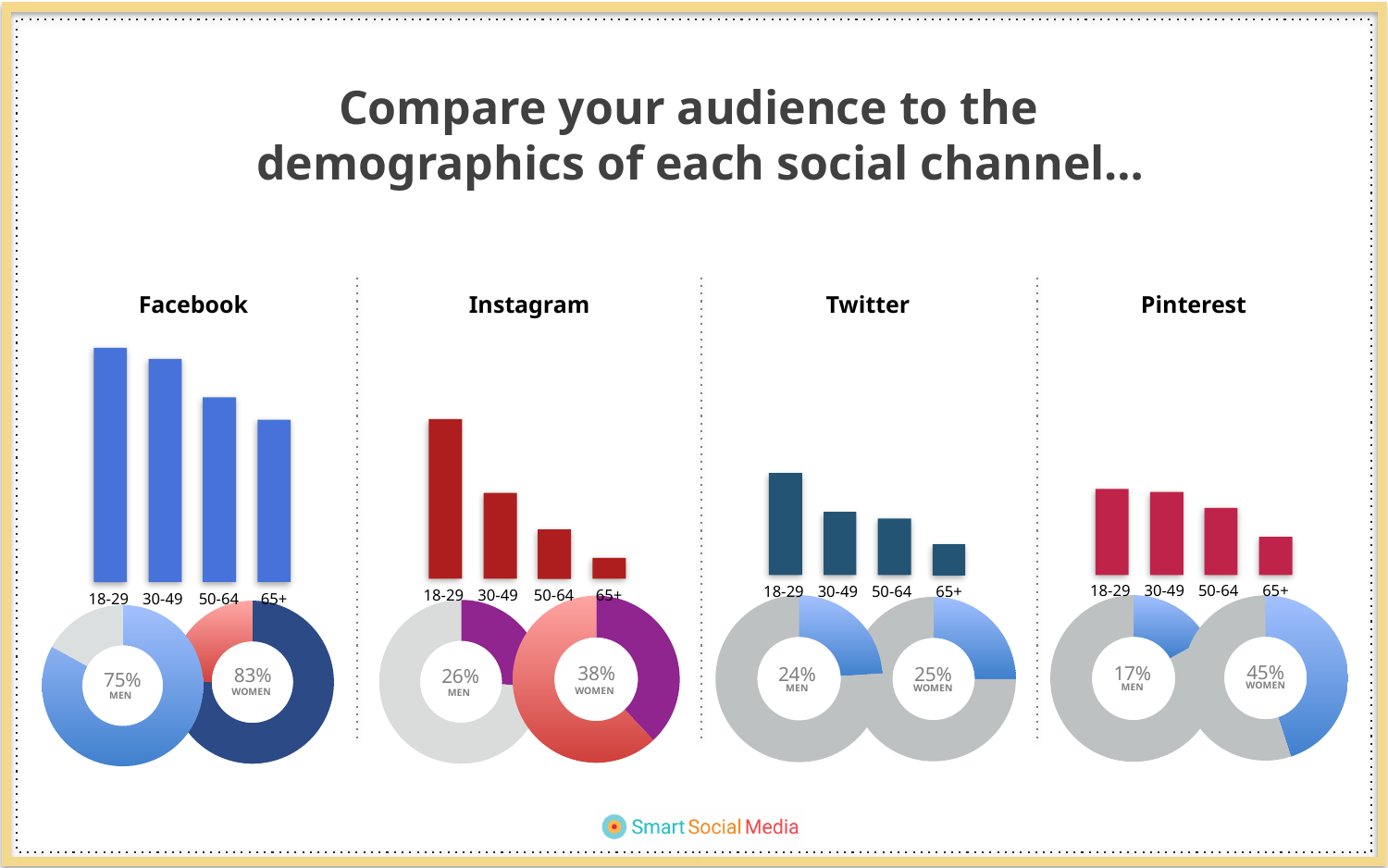
On the Facebook donut charts, what percentage is shown for women? 83% On the Facebook donut charts, what is the difference between the women's and men's percentages? 8% On the Instagram donut charts, which is larger, the men's or the women's percentage? Women On the Twitter donut charts, what percentage is shown for men? 24% How many age-group bars are in the Twitter bar chart? 4 On the Instagram donut charts, what percentage is shown for men? 26% In the Instagram bar chart, which age group has the tallest bar? 18-29 In the Pinterest bar chart, do the bar heights rise or fall from 18-29 to 65+? Fall On the Pinterest donut charts, what percentage is shown for women? 45% In the Facebook bar chart, which age group has the shortest bar? 65+ On the Pinterest donut charts, what is the difference between the women's and men's percentages? 28% Across the four channels' men's donut charts, which channel has the lowest men's percentage? Pinterest